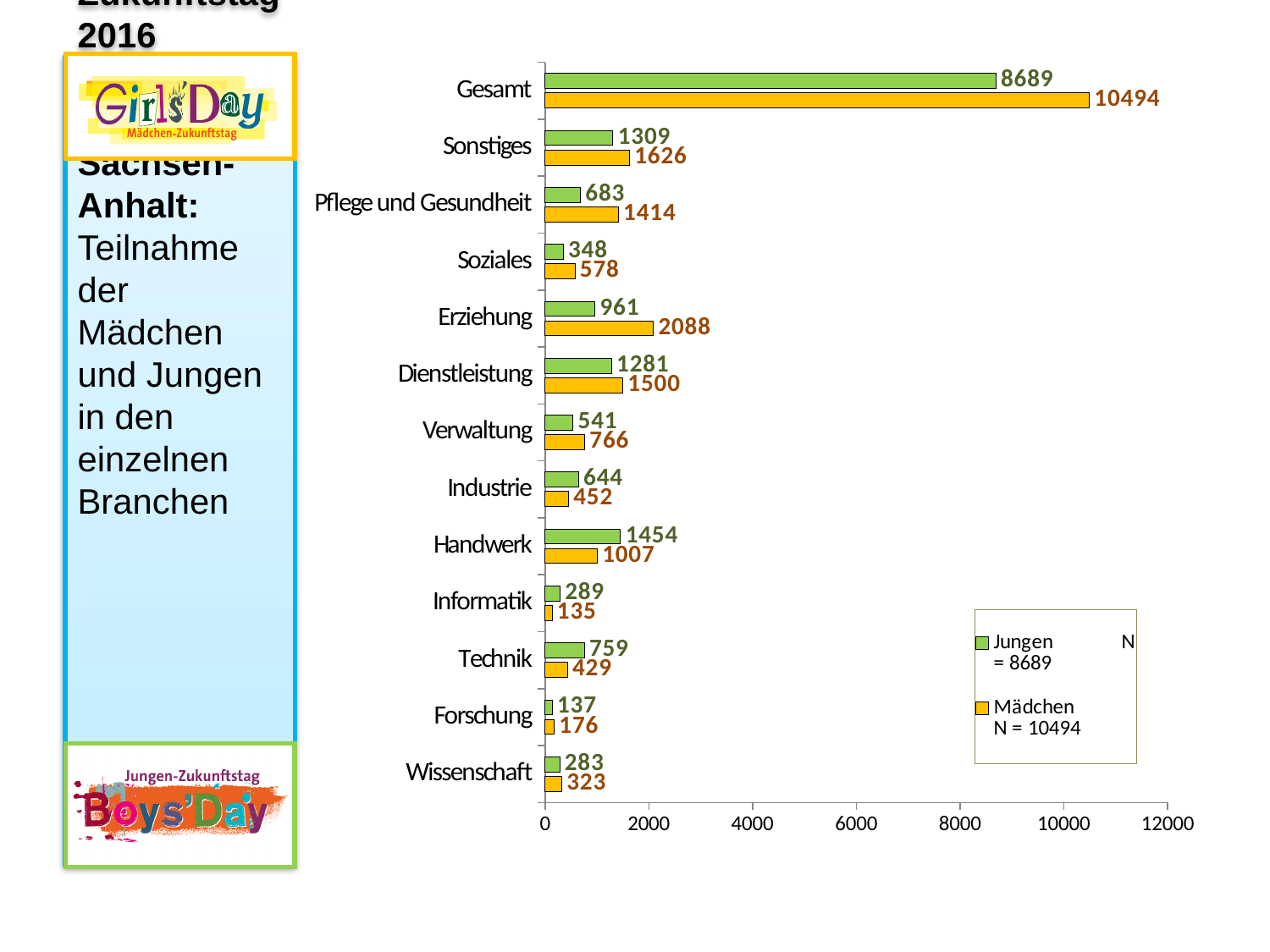
What is the value for Jungen in the Handwerk category? 1454 Is the Mädchen value for Gesamt greater or less than 10000? greater Excluding Gesamt, which category has the highest value for Mädchen? Erziehung Which is larger in the Technik category, the Jungen value or the Mädchen value? Jungen What kind of chart is shown on the slide? bar chart Excluding Gesamt, which category has the lowest value for Jungen? Forschung How many series does the legend list? 2 What is the difference between the Mädchen and Jungen values for Pflege und Gesundheit? 731 What is the value for Mädchen in the Erziehung category? 2088 Which colour represents the Mädchen series in the chart? orange How many categories are shown on the y axis of the chart? 13 What is the value for Mädchen in the Informatik category? 135